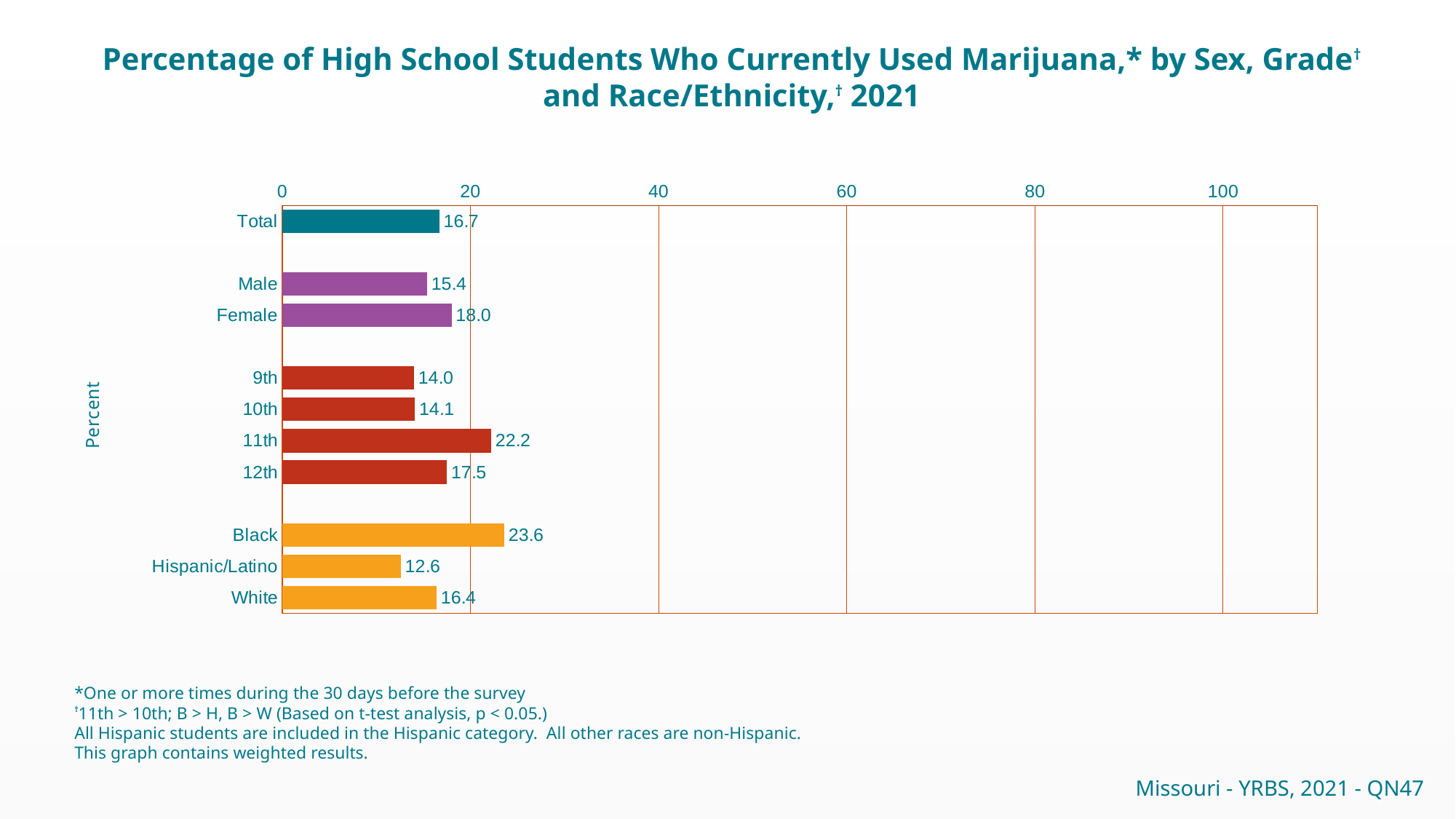
Which category has the lowest value? Hispanic/Latino Is the value for Black greater or less than 20? greater What is the difference between the values for Female and Male? 2.6 Which is larger, the value for 12th grade or the value for 9th grade? 12th What is the value for Female? 18.0 What kind of chart is shown on the slide? bar chart How many categories are shown in the chart? 11 What is the value for Hispanic/Latino? 12.6 What is the value for Total? 16.7 What is the value for 11th grade? 22.2 Which category has the highest value? Black What is the difference between the values for Black and White? 7.2